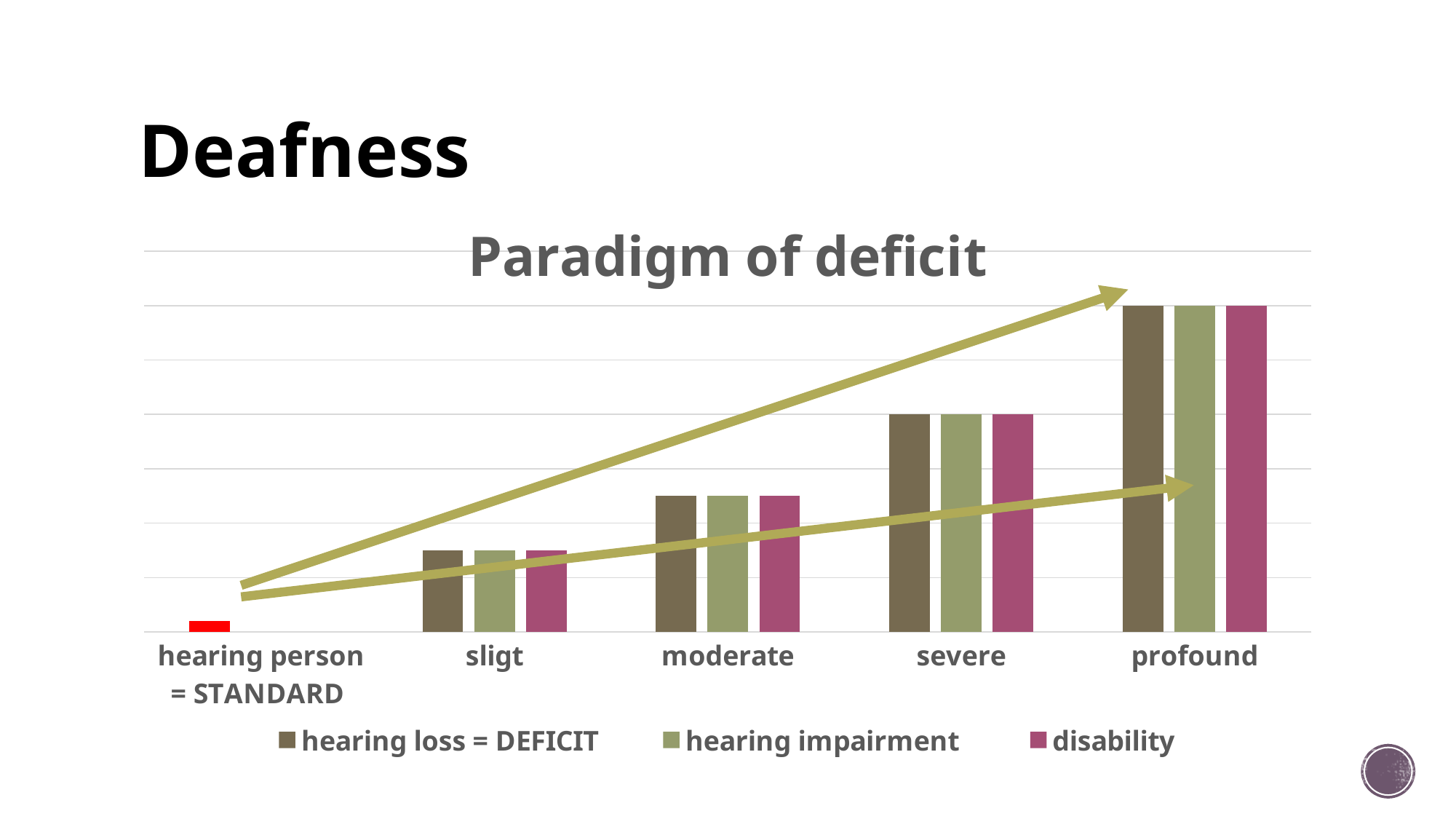
Which category has the highest bars? profound What is the title of the chart? Paradigm of deficit Which is larger, the hearing loss = DEFICIT value for severe or for moderate? severe Which category has the lowest bar? hearing person = STANDARD Which series is listed first in the legend? hearing loss = DEFICIT How many series does the legend list? 3 Which category comes immediately after moderate on the x axis? severe What kind of chart is shown on the slide? bar chart How many categories are shown on the x axis? 5 Which is larger, the disability value for sligt or for profound? profound Do the bar values rise or fall from left to right along the x axis? rise